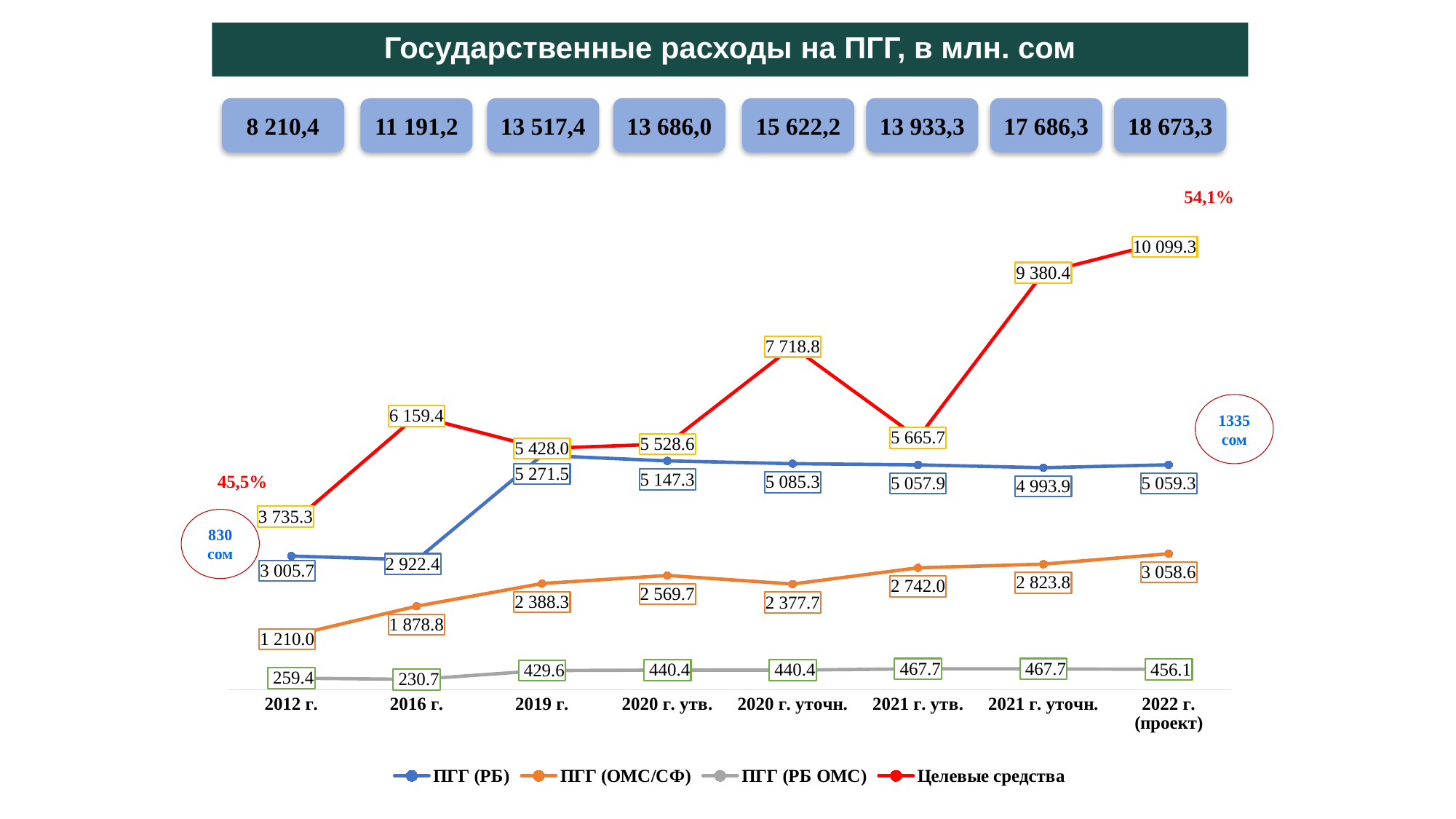
How many series does the legend list? 4 What kind of chart is shown on the slide? line chart What is the value of Целевые средства for 2022 г. (проект)? 10 099.3 In which category does ПГГ (РБ) reach its highest value? 2019 г. Does ПГГ (ОМС/СФ) generally rise or fall from 2012 г. to 2022 г. (проект)? rise What is the difference between Целевые средства in 2021 г. уточн. and 2021 г. утв.? 3 714.7 In which category is Целевые средства lowest? 2012 г. What is the value of ПГГ (ОМС/СФ) for 2016 г.? 1 878.8 What is the value of ПГГ (РБ ОМС) for 2019 г.? 429.6 Which is larger in 2020 г. уточн.: ПГГ (РБ) or Целевые средства? Целевые средства What is the title of the chart? Государственные расходы на ПГГ, в млн. сом How many categories are shown along the x axis? 8